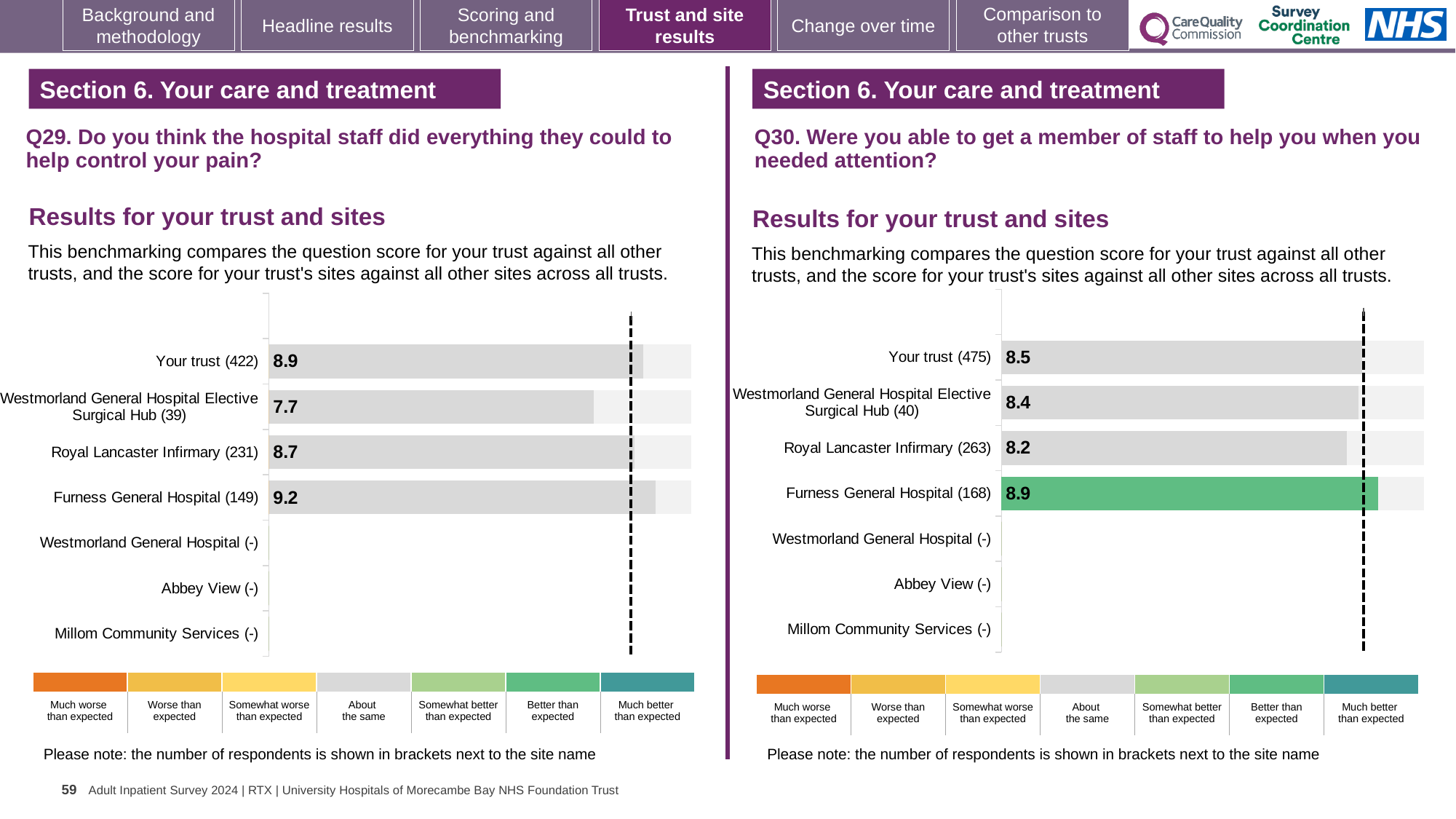
In the Q30 chart on the right, what is the score for Furness General Hospital (168)? 8.9 In the Q30 chart on the right, what is the difference between the scores for Furness General Hospital (168) and Your trust (475)? 0.4 In the Q29 chart on the left, what is the difference between the scores for Furness General Hospital (149) and Royal Lancaster Infirmary (231)? 0.5 What kind of chart is the Q30 chart on the right? Bar chart In the Q29 chart on the left, what is the score for Westmorland General Hospital Elective Surgical Hub (39)? 7.7 How many categories are listed on the y axis of the Q29 chart on the left? 7 In the Q29 chart on the left, what is the score for Your trust (422)? 8.9 In the Q30 chart on the right, what is the score for Royal Lancaster Infirmary (263)? 8.2 In the Q29 chart on the left, which site has the highest score? Furness General Hospital (149) In the Q29 chart on the left, which site has the lowest score? Westmorland General Hospital Elective Surgical Hub (39) In the Q30 chart on the right, which is larger: the score for Your trust (475) or for Westmorland General Hospital Elective Surgical Hub (40)? Your trust (475) In the Q30 chart on the right, which site has the lowest score? Royal Lancaster Infirmary (263)